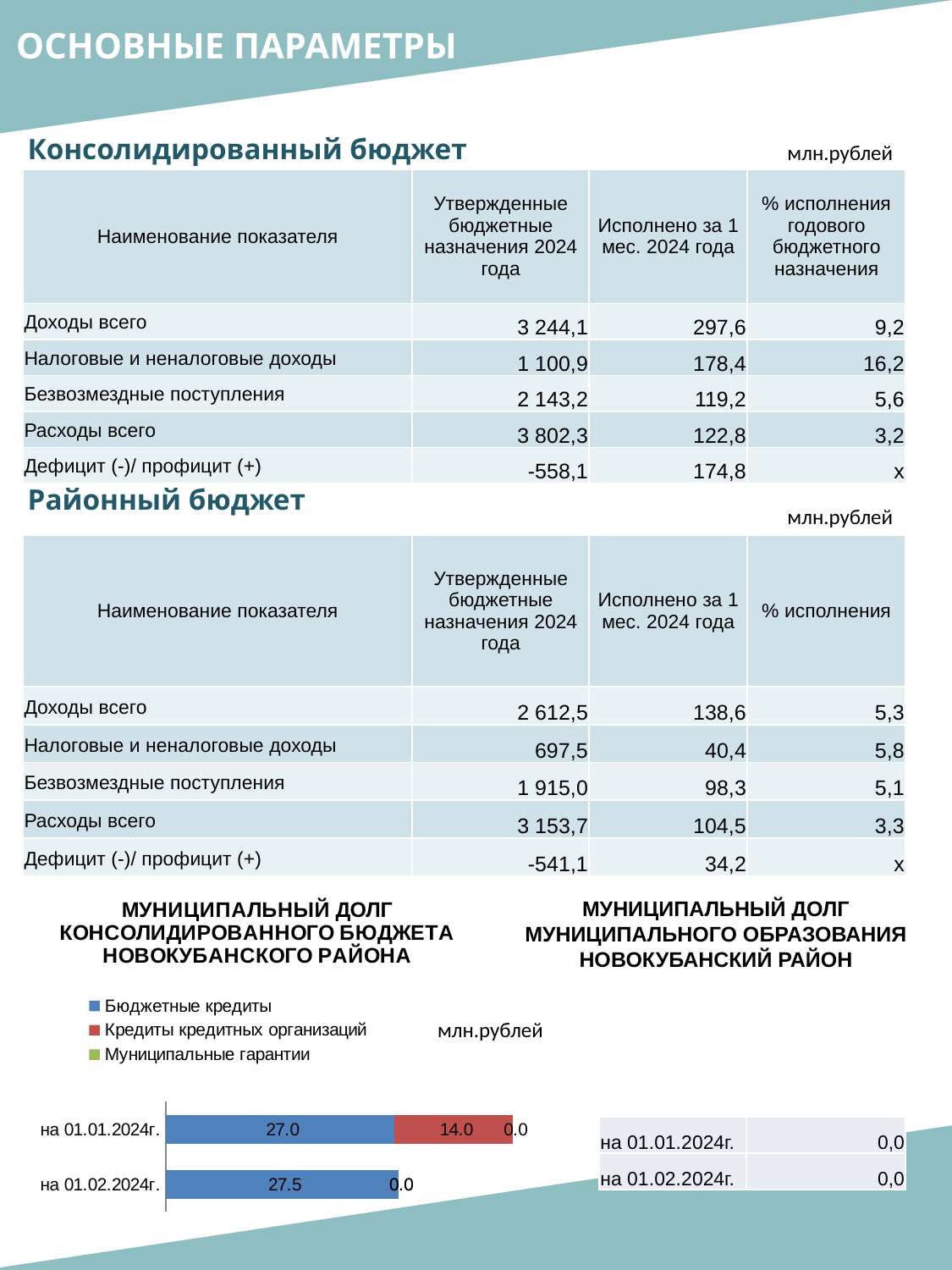
On the municipal debt chart, what is the value of Бюджетные кредиты on 01.01.2024? 27.0 On the municipal debt chart, does the value of Бюджетные кредиты rise or fall from 01.01.2024 to 01.02.2024? rise On the municipal debt chart, what is the value of Муниципальные гарантии on 01.02.2024? 0.0 How many dates (categories) are plotted on the municipal debt chart? 2 How many series does the legend of the municipal debt chart list? 3 On the municipal debt chart, what is the total of the stacked bar for 01.01.2024? 41.0 What kind of chart is shown for the municipal debt of the consolidated budget of Novokubansky district? bar chart On the municipal debt chart, what is the value of Бюджетные кредиты on 01.02.2024? 27.5 On the municipal debt chart, what is the value of Кредиты кредитных организаций on 01.01.2024? 14.0 On the municipal debt chart, what is the difference between Бюджетные кредиты on 01.02.2024 and on 01.01.2024? 0.5 On the municipal debt chart, which colour represents Кредиты кредитных организаций? red On the municipal debt chart, which is larger on 01.01.2024: Бюджетные кредиты or Кредиты кредитных организаций? Бюджетные кредиты